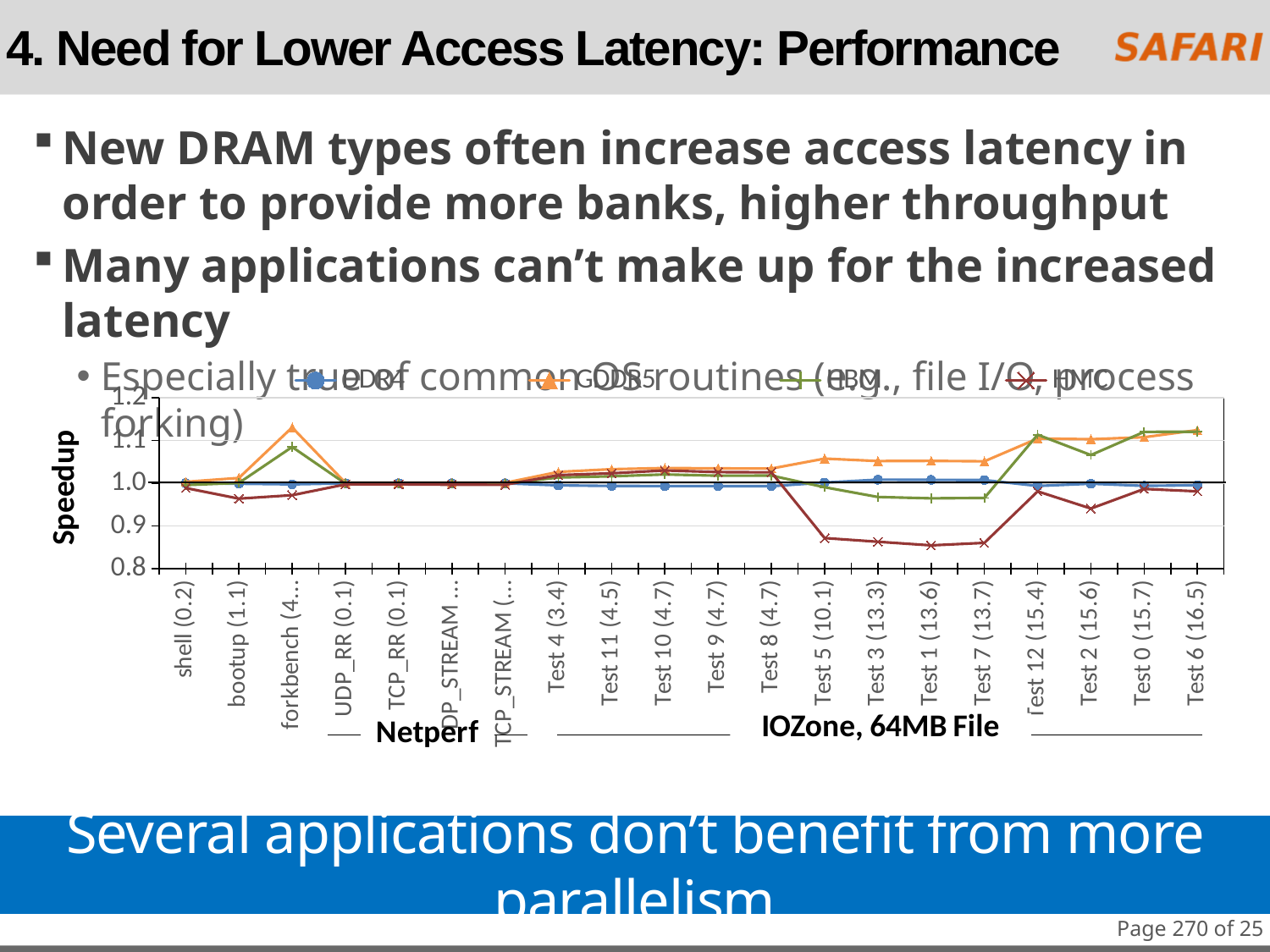
Is the HBM value for Test 3 (13.3) greater or less than 1.0? less For Test 5 (10.1), which series has the larger speedup, GDDR5 or HBM? GDDR5 Is the value of the red x-marker series for Test 5 (10.1) greater or less than 0.9? less How many categories are plotted along the x axis of the chart? 20 Is the GDDR5 value for forkbench greater or less than 1.1? greater What is the label of the y axis of the chart? Speedup Which two benchmark group labels appear beneath the x axis of the chart? Netperf and IOZone, 64MB File How many series does the chart's legend list? 4 What kind of chart is shown on the slide? line chart Which series has the lowest speedup for Test 5 (10.1)? HMC Which series has the highest speedup for forkbench? GDDR5